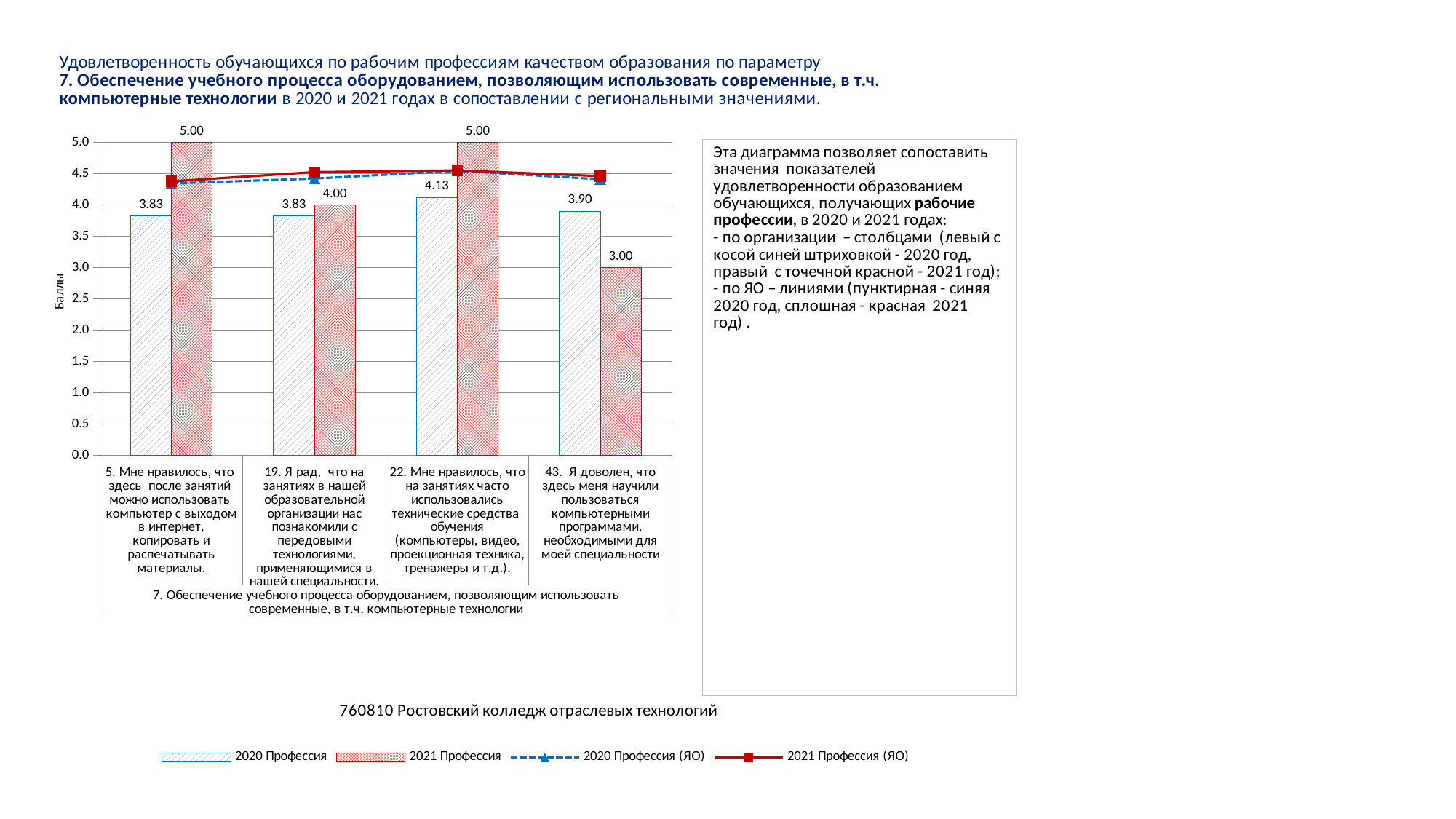
How many categories are shown on the x axis of the chart? 4 What is the value of the 2021 Профессия bar for category 43 (Я доволен, что здесь меня научили пользоваться компьютерными программами)? 3.00 Which category has the lowest 2021 Профессия bar? 43. Я доволен, что здесь меня научили пользоваться компьютерными программами, необходимыми для моей специальности What is the label of the vertical axis? Баллы What is the difference between the 2021 Профессия and 2020 Профессия values for category 5 (Мне нравилось, что здесь после занятий можно использовать компьютер)? 1.17 What is the value of the 2020 Профессия bar for category 22 (Мне нравилось, что на занятиях часто использовались технические средства обучения)? 4.13 Which category has the highest 2020 Профессия bar? 22. Мне нравилось, что на занятиях часто использовались технические средства обучения For category 43, which is larger: the 2020 Профессия bar or the 2021 Профессия bar? 2020 Профессия What kind of chart is shown on the slide? Combined bar and line chart Is the 2021 Профессия (ЯО) line value for category 5 greater or less than 4.0? greater How many series does the legend list? 4 What is the value of the 2021 Профессия bar for category 19 (Я рад, что на занятиях в нашей образовательной организации нас познакомили с передовыми технологиями)? 4.00